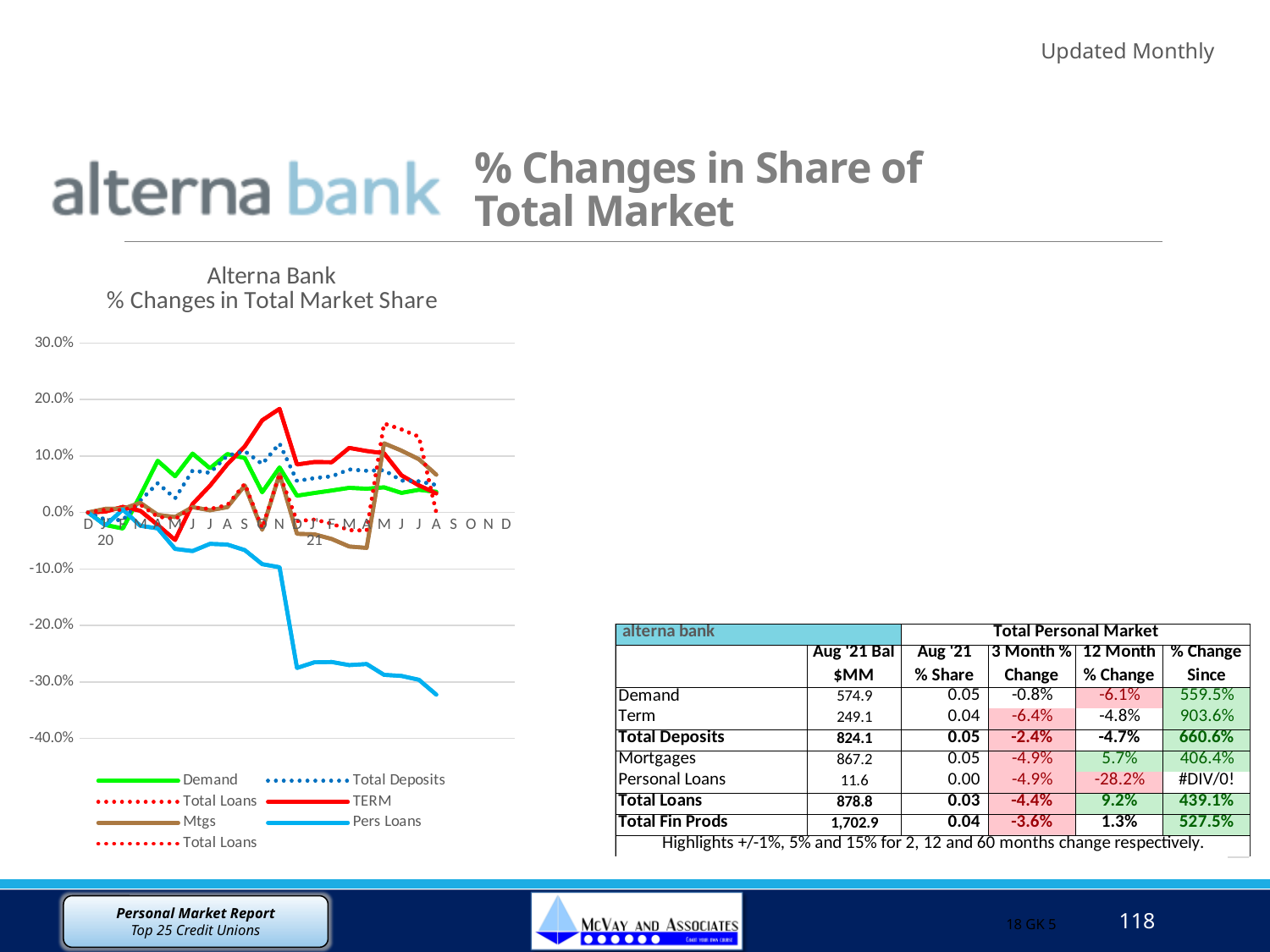
Which series reaches the lowest value on the chart? Pers Loans Which series reaches the highest value on the chart? TERM What is the highest value shown on the chart's vertical axis? 30.0% Is the peak value of the TERM series greater or less than 10.0%? greater Does the Pers Loans series rise or fall over the period shown? fall What is the title of the chart? Alterna Bank % Changes in Total Market Share Is the Pers Loans series greater or less than the Demand series at the end of the period? less What kind of chart is shown on the slide? line chart Is the final value of the Pers Loans series greater or less than -20.0%? less How many series does the chart legend list? 7